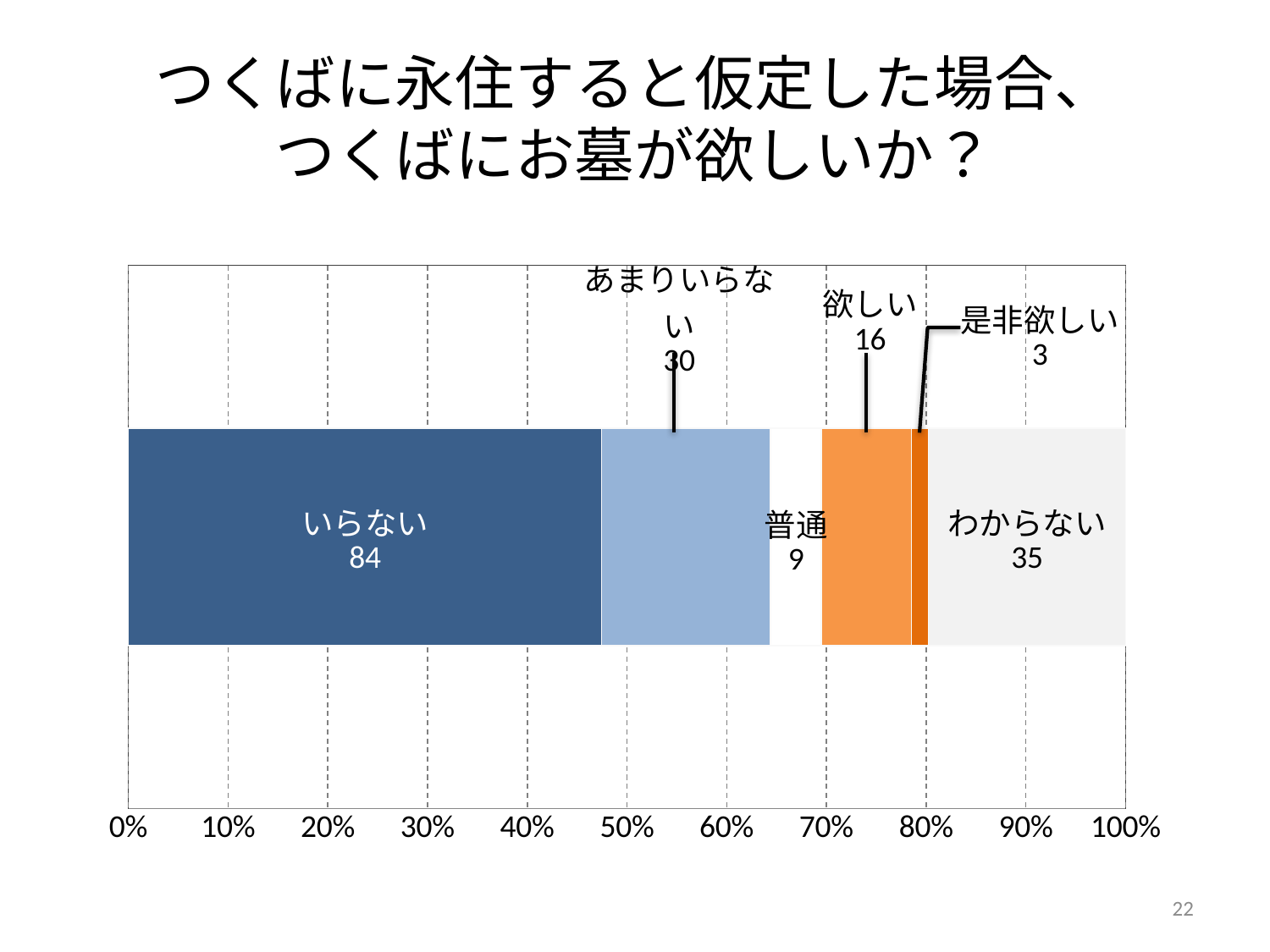
What is the value for あまりいらない? 30 How many categories are shown in the bar? 6 What kind of chart is shown on the slide? Stacked bar chart What is the value for わからない? 35 Which category has the highest value? いらない What is the value for いらない? 84 Which category has the lowest value? 是非欲しい What is the value for 欲しい? 16 What is the value for 普通? 9 Which is larger, the value for 欲しい or the value for 普通? 欲しい What is the difference between the values for いらない and わからない? 49 What is the value for 是非欲しい? 3